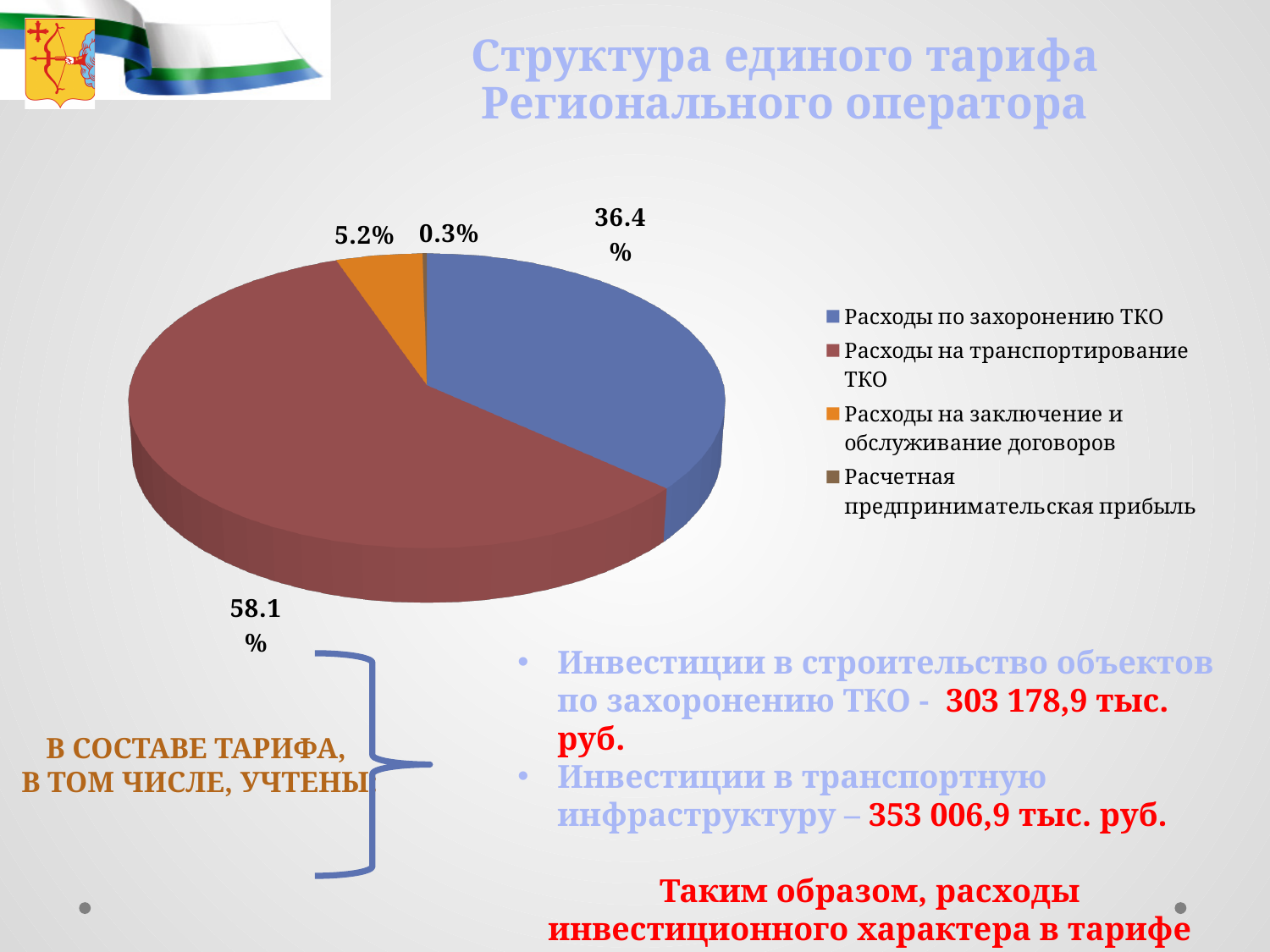
What is the difference in percentage points between 'Расходы на транспортирование ТКО' and 'Расходы по захоронению ТКО'? 21.7 What share of the tariff is 'Расходы по захоронению ТКО'? 36.4% What is the title of the slide containing the pie chart? Структура единого тарифа Регионального оператора What share of the tariff is 'Расходы на транспортирование ТКО'? 58.1% Which category has the largest share of the pie? Расходы на транспортирование ТКО What kind of chart is shown on the slide? Pie chart What colour is the slice for 'Расходы по захоронению ТКО'? Blue How many categories does the legend of the pie chart list? 4 What share of the tariff is 'Расходы на заключение и обслуживание договоров'? 5.2% Which is larger: the share for 'Расходы по захоронению ТКО' or for 'Расходы на заключение и обслуживание договоров'? Расходы по захоронению ТКО Which category has the smallest share of the pie? Расчетная предпринимательская прибыль What share of the tariff is 'Расчетная предпринимательская прибыль'? 0.3%